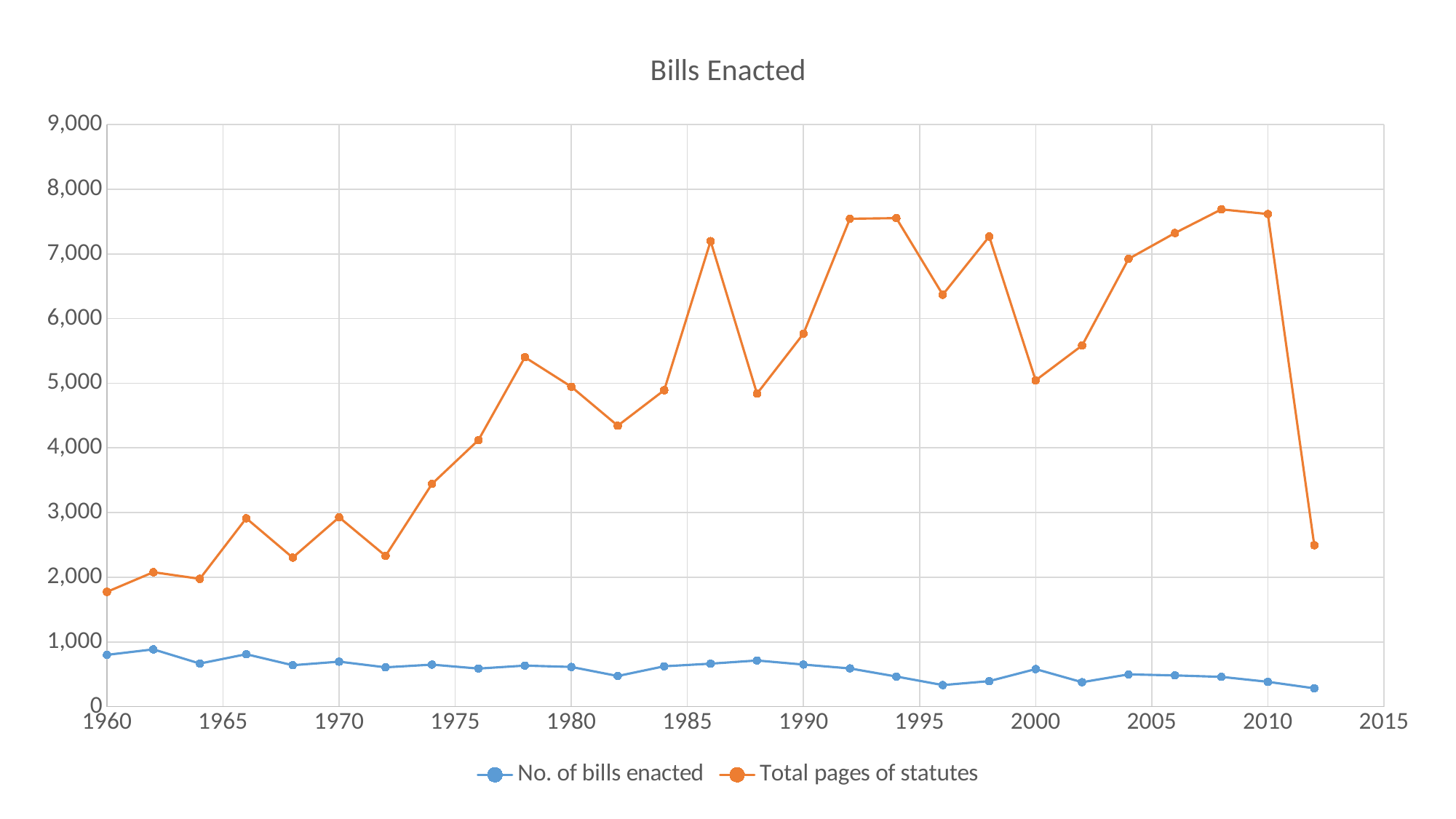
How many series does the legend list? 2 Is the value for Total pages of statutes in 1986 greater or less than 7,000? greater Which series is drawn in orange? Total pages of statutes What kind of chart is shown on the slide? line chart Is the value for Total pages of statutes in 2012 greater or less than 3,000? less Is the value for No. of bills enacted in 1996 greater or less than 500? less In which year is the value for No. of bills enacted highest? 1962 In which year is the value for No. of bills enacted lowest? 2012 Does the No. of bills enacted series generally rise or fall from 1960 to 2012? fall What is the title of the chart? Bills Enacted Which is larger for Total pages of statutes: the value in 1992 or the value in 2000? 1992 In which year is the value for Total pages of statutes lowest? 1960